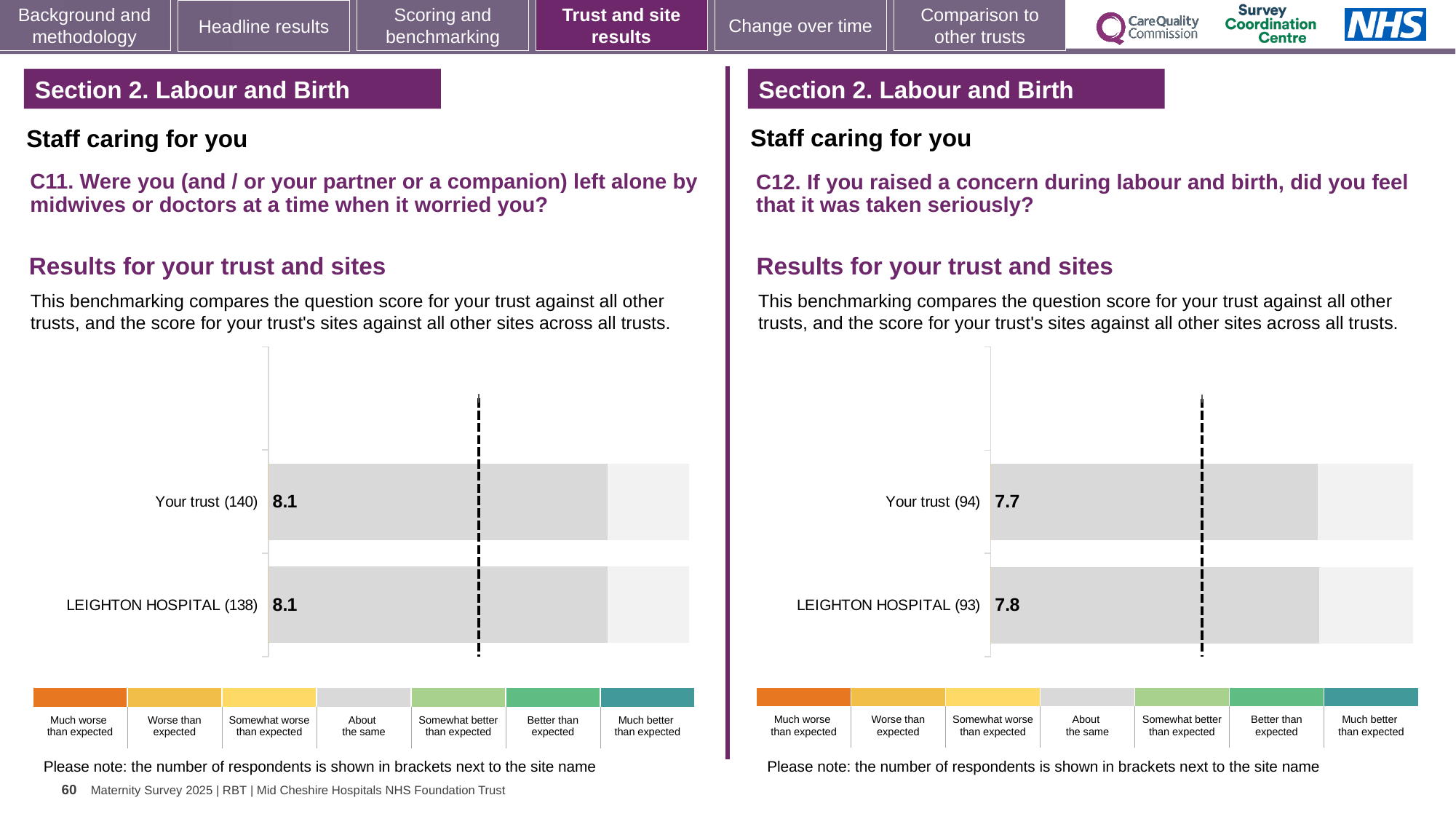
In the C11 chart on the left, is the score for Your trust higher than, lower than, or the same as the score for LEIGHTON HOSPITAL? the same In the C12 chart on the right, what is the score for Your trust (94)? 7.7 In the C12 chart on the right, which has the higher score, Your trust or LEIGHTON HOSPITAL? LEIGHTON HOSPITAL In the C12 chart on the right, what is the score for LEIGHTON HOSPITAL (93)? 7.8 In the C11 chart on the left, what is the score for LEIGHTON HOSPITAL (138)? 8.1 In the C11 chart on the left, what is the score for Your trust (140)? 8.1 In the C12 chart on the right, is the score for Your trust greater or less than 8? less In the C12 chart on the right, what is the difference between the LEIGHTON HOSPITAL score and the Your trust score? 0.1 How many bars are plotted in the C11 chart on the left? 2 What type of chart is used for the C12 results on the right? bar chart In the C12 chart on the right, how many respondents are shown in brackets for LEIGHTON HOSPITAL? 93 In the C11 chart on the left, how many respondents are shown in brackets for Your trust? 140